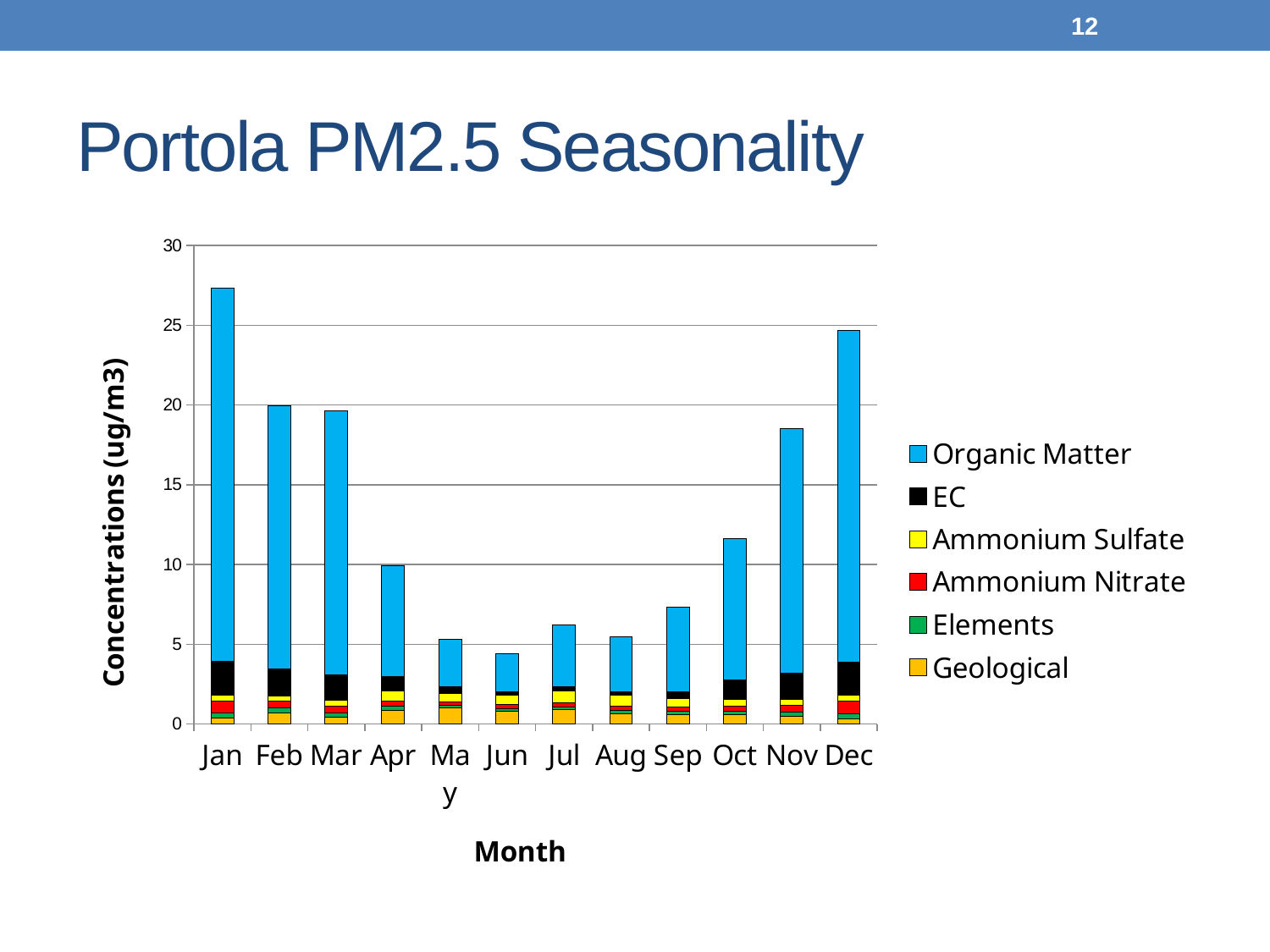
Which month has the lowest total PM2.5 concentration? Jun How many series does the chart's legend list? 6 Which month has a larger total concentration, Jan or Dec? Jan Which month has the highest total PM2.5 concentration? Jan Is the total concentration for Oct greater or less than 10? greater Is the total concentration for Nov greater or less than 20? less Is the total concentration for Jan greater or less than 25? greater How many months are shown on the x axis of the chart? 12 What kind of chart is shown on the slide? bar chart Do the total concentrations rise or fall from Jan to Jun? fall What is the title of the y axis? Concentrations (ug/m3)